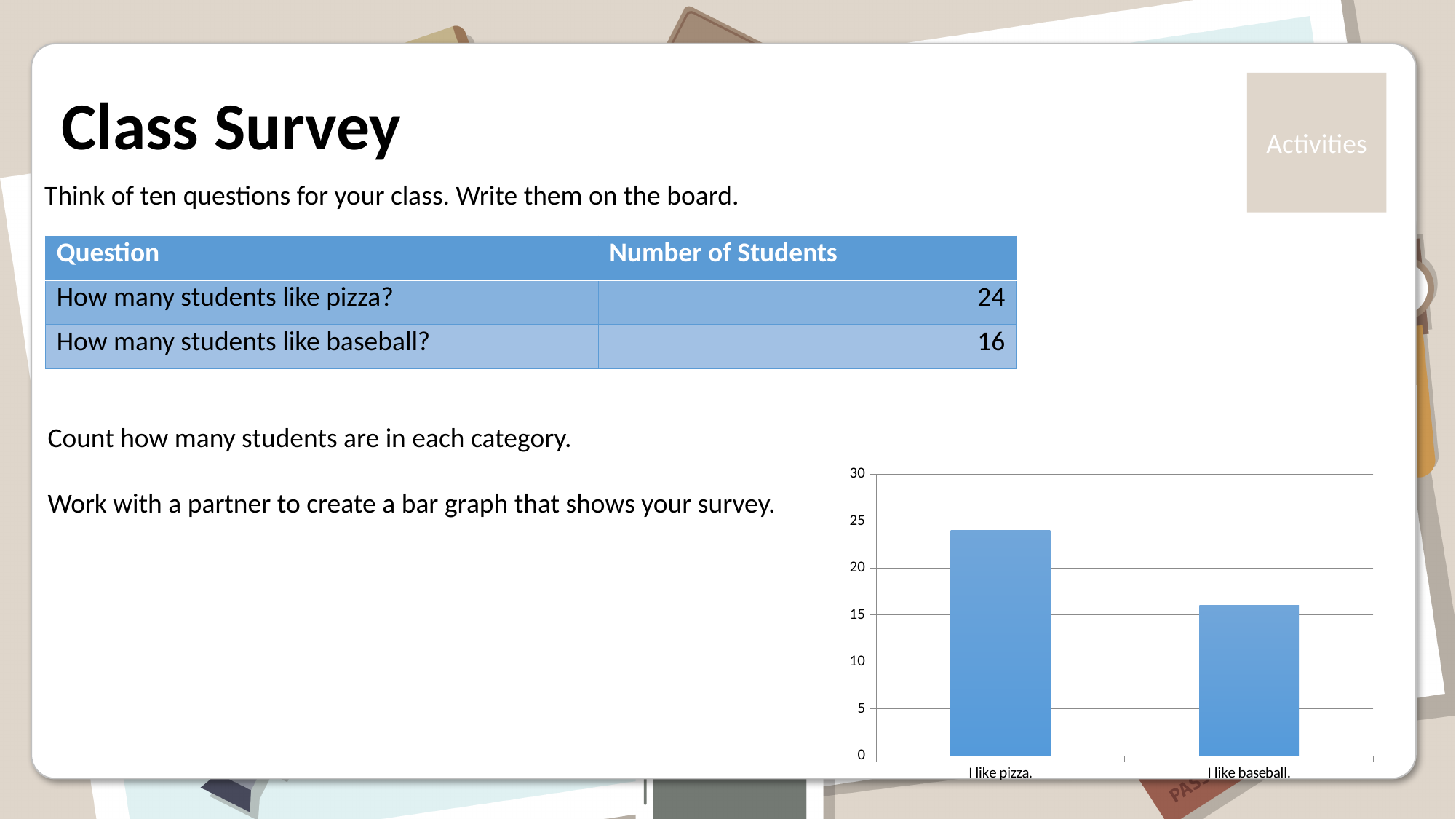
Which category has the taller bar in the chart? I like pizza. Is the bar for 'I like baseball.' greater or less than 20? less How many bars does the chart show? 2 What is the number of students who like pizza, as shown in the table and plotted in the chart? 24 Is the bar for 'I like pizza.' taller or shorter than the bar for 'I like baseball.'? taller What is the number of students who like baseball, as shown in the table and plotted in the chart? 16 Is the bar for 'I like baseball.' greater or less than 15? greater Is the bar for 'I like pizza.' greater or less than 25? less What is the highest value shown on the chart's vertical axis? 30 What kind of chart is shown on the slide? bar chart Which category has the shorter bar in the chart? I like baseball.